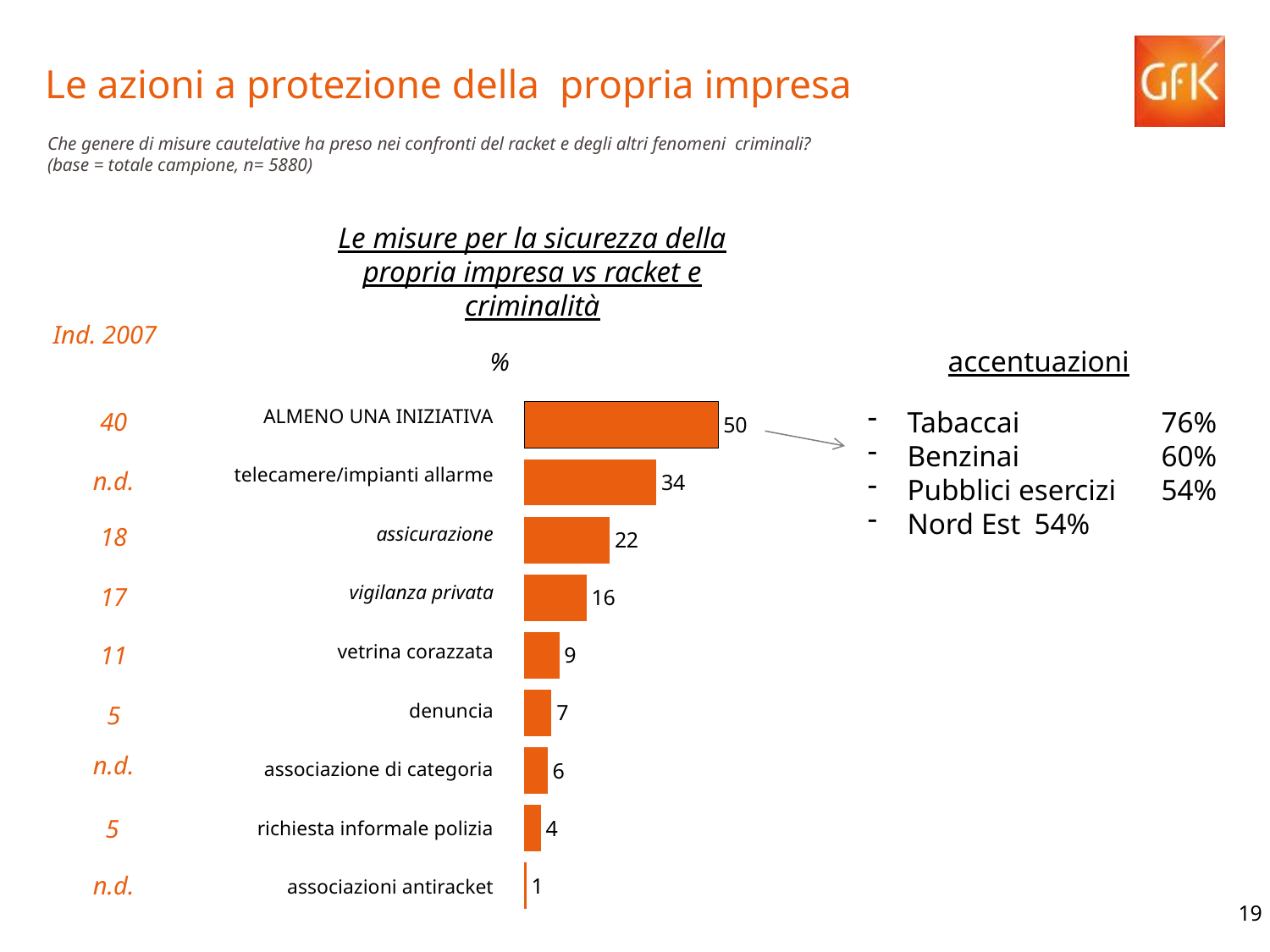
What is the value for 'vigilanza privata' in the chart? 16 How many categories are shown in the chart? 9 What is the value for 'denuncia' in the chart? 7 What colour are the bars in the chart? orange What is the difference between the values for 'ALMENO UNA INIZIATIVA' and 'telecamere/impianti allarme'? 16 Which is larger: the value for 'associazione di categoria' or the value for 'richiesta informale polizia'? associazione di categoria Which category has the highest value in the chart? ALMENO UNA INIZIATIVA What kind of chart is shown on the slide? bar chart What is the title of the chart? Le misure per la sicurezza della propria impresa vs racket e criminalità What is the difference between the values for 'assicurazione' and 'vetrina corazzata'? 13 What is the value for 'telecamere/impianti allarme' in the chart? 34 Which category has the lowest value in the chart? associazioni antiracket